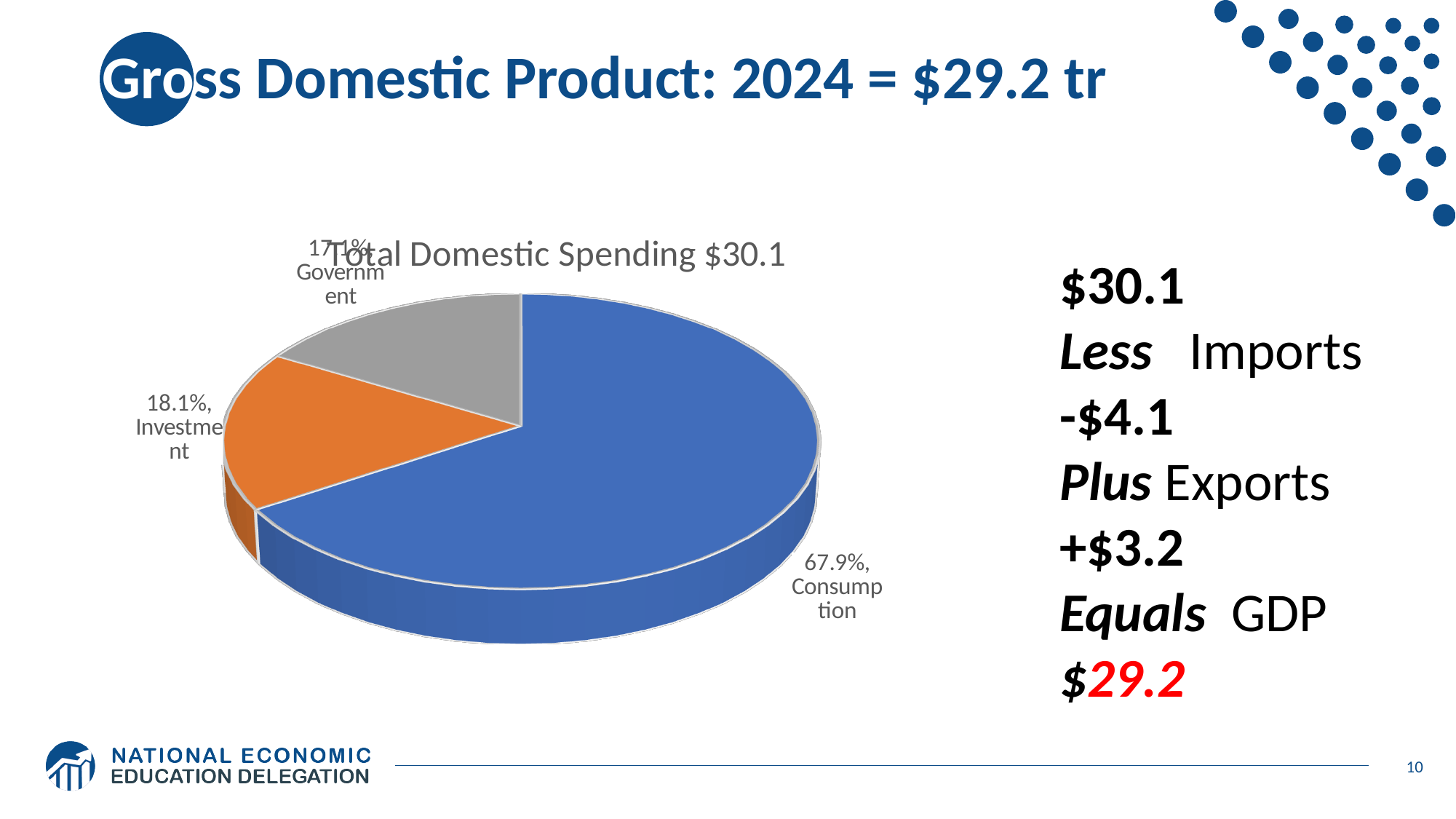
What colour is the Consumption slice? Blue What is the title of the chart? Total Domestic Spending $30.1 How many categories are shown in the pie chart? 3 Does Consumption account for more or less than half of Total Domestic Spending? More What kind of chart is shown on the slide? Pie chart By how many percentage points does the Consumption share exceed the Investment share? 49.8 percentage points Which category has the smallest slice of the pie? Government Which is larger, the Consumption share or the Investment share? Consumption What share of Total Domestic Spending is Investment? 18.1% Which category has the largest slice of the pie? Consumption What share of Total Domestic Spending is Consumption? 67.9%